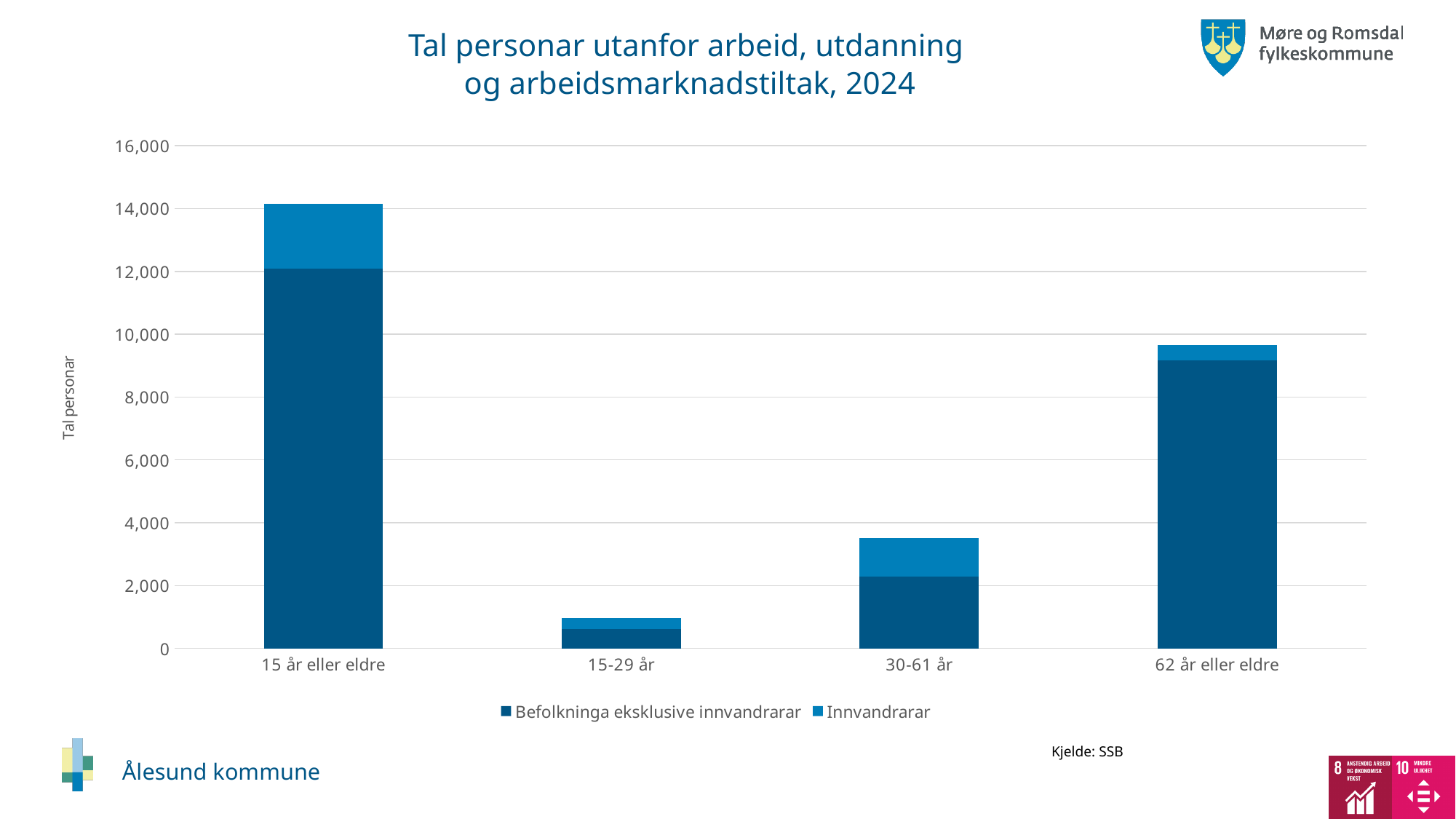
Is the total stacked value for 15 år eller eldre greater or less than 12,000? greater How many age categories are shown on the x axis? 4 How many series does the legend list? 2 Is the total stacked value for 62 år eller eldre greater or less than 10,000? less Which category has the shortest stacked bar? 15-29 år Is the total stacked value for 30-61 år greater or less than 4,000? less Which stacked bar is taller, 30-61 år or 62 år eller eldre? 62 år eller eldre Which category has the tallest stacked bar? 15 år eller eldre What are the two series named in the legend? Befolkninga eksklusive innvandrarar; Innvandrarar What kind of chart is shown on the slide? bar chart What is the title of the chart? Tal personar utanfor arbeid, utdanning og arbeidsmarknadstiltak, 2024